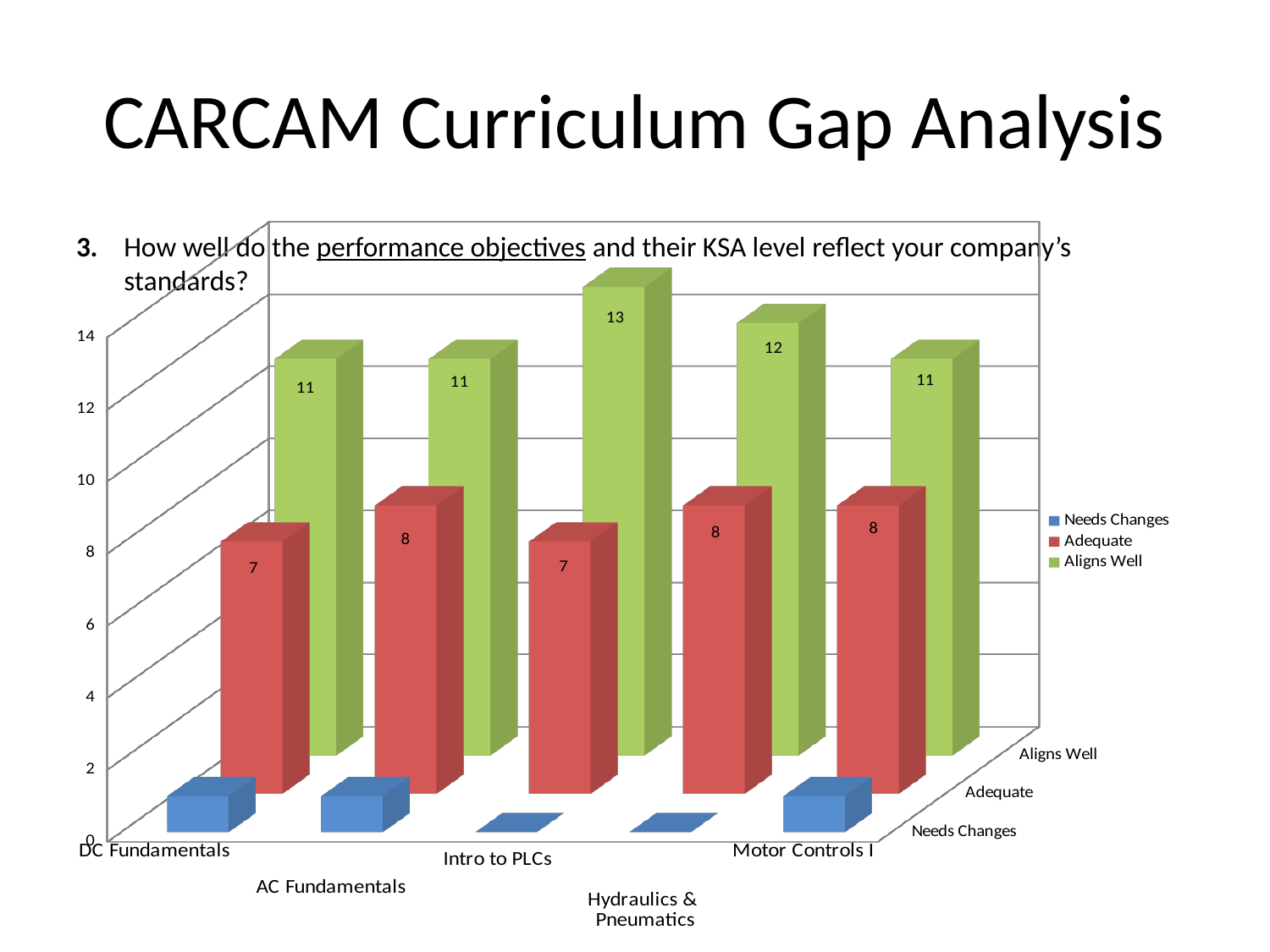
How many course categories are shown on the x axis? 5 Which category has the highest Aligns Well value? Intro to PLCs Is the Needs Changes value for DC Fundamentals greater or less than 4? less What is the Aligns Well value for Intro to PLCs? 13 How many series does the legend list? 3 What is the Adequate value for DC Fundamentals? 7 What is the difference between the Aligns Well values for Intro to PLCs and DC Fundamentals? 2 What is the Adequate value for Motor Controls I? 8 Which is larger, the Adequate value for AC Fundamentals or the Adequate value for Intro to PLCs? AC Fundamentals What is the Aligns Well value for Hydraulics & Pneumatics? 12 What kind of chart is shown on the slide? bar chart What is the difference between the Aligns Well and Adequate values for Intro to PLCs? 6